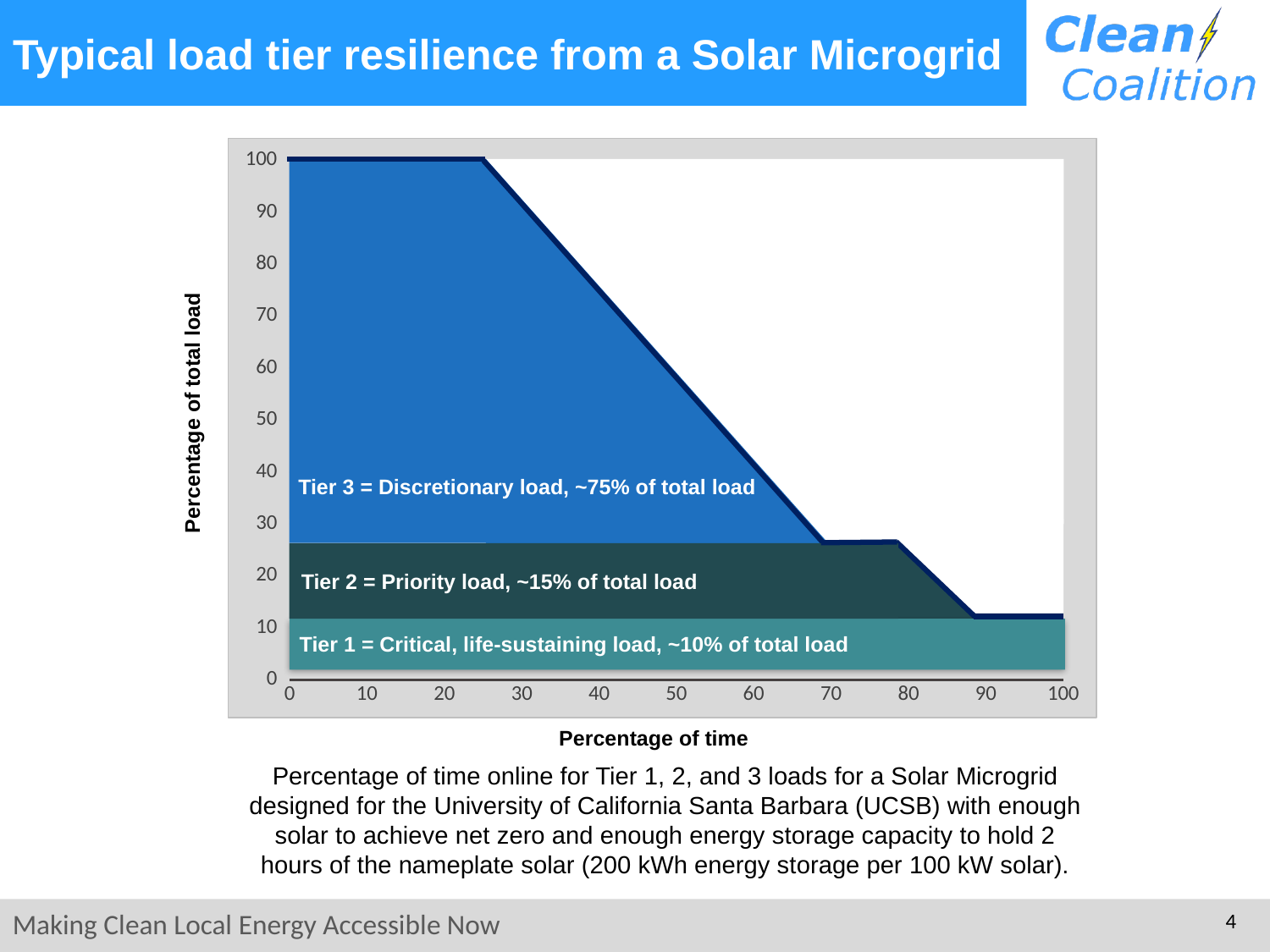
How many load tiers are labelled in the chart? 3 Do the plotted values rise or fall as the percentage of time increases along the x axis? fall Which tier is labelled with the largest share of total load, Tier 1 or Tier 3? Tier 3 What is the title of the chart's horizontal axis? Percentage of time According to the chart label, what share of total load is Tier 1 (Critical, life-sustaining load)? ~10% According to the chart label, what share of total load is Tier 3 (Discretionary load)? ~75% Is the percentage of total load at 30% of time greater or less than 80? greater What is the title of the chart's vertical axis? Percentage of total load According to the chart label, what share of total load is Tier 2 (Priority load)? ~15% What kind of chart is shown on the slide? area chart What percentage of total load is served at 0% of time, where the line begins? 100 Is the percentage of total load at 90% of time greater or less than 20? less